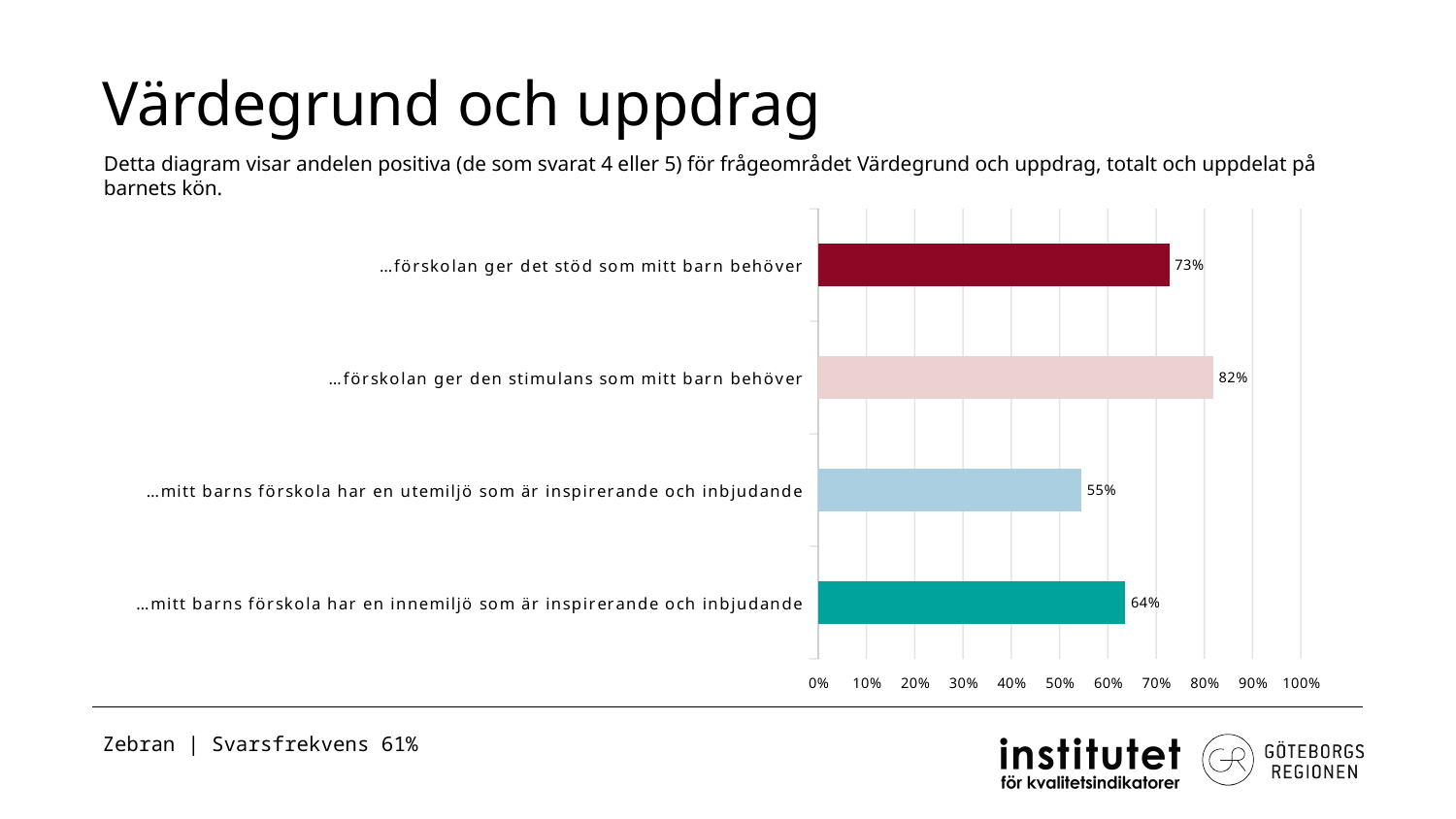
What is the value for "…förskolan ger det stöd som mitt barn behöver"? 73% Is the value for "…mitt barns förskola har en utemiljö som är inspirerande och inbjudande" greater or less than 60%? less What is the difference between the values for the innemiljö category and the utemiljö category? 9% What is the value for "…förskolan ger den stimulans som mitt barn behöver"? 82% What is the value for "…mitt barns förskola har en innemiljö som är inspirerande och inbjudande"? 64% How many categories are shown in the chart? 4 Which category has the lowest value? …mitt barns förskola har en utemiljö som är inspirerande och inbjudande Which is larger: the value for "…förskolan ger det stöd som mitt barn behöver" or the value for "…mitt barns förskola har en innemiljö som är inspirerande och inbjudande"? …förskolan ger det stöd som mitt barn behöver What kind of chart is shown on the slide? bar chart What is the difference between the values for "…förskolan ger den stimulans som mitt barn behöver" and "…förskolan ger det stöd som mitt barn behöver"? 9% Which category has the highest value? …förskolan ger den stimulans som mitt barn behöver What is the value for "…mitt barns förskola har en utemiljö som är inspirerande och inbjudande"? 55%